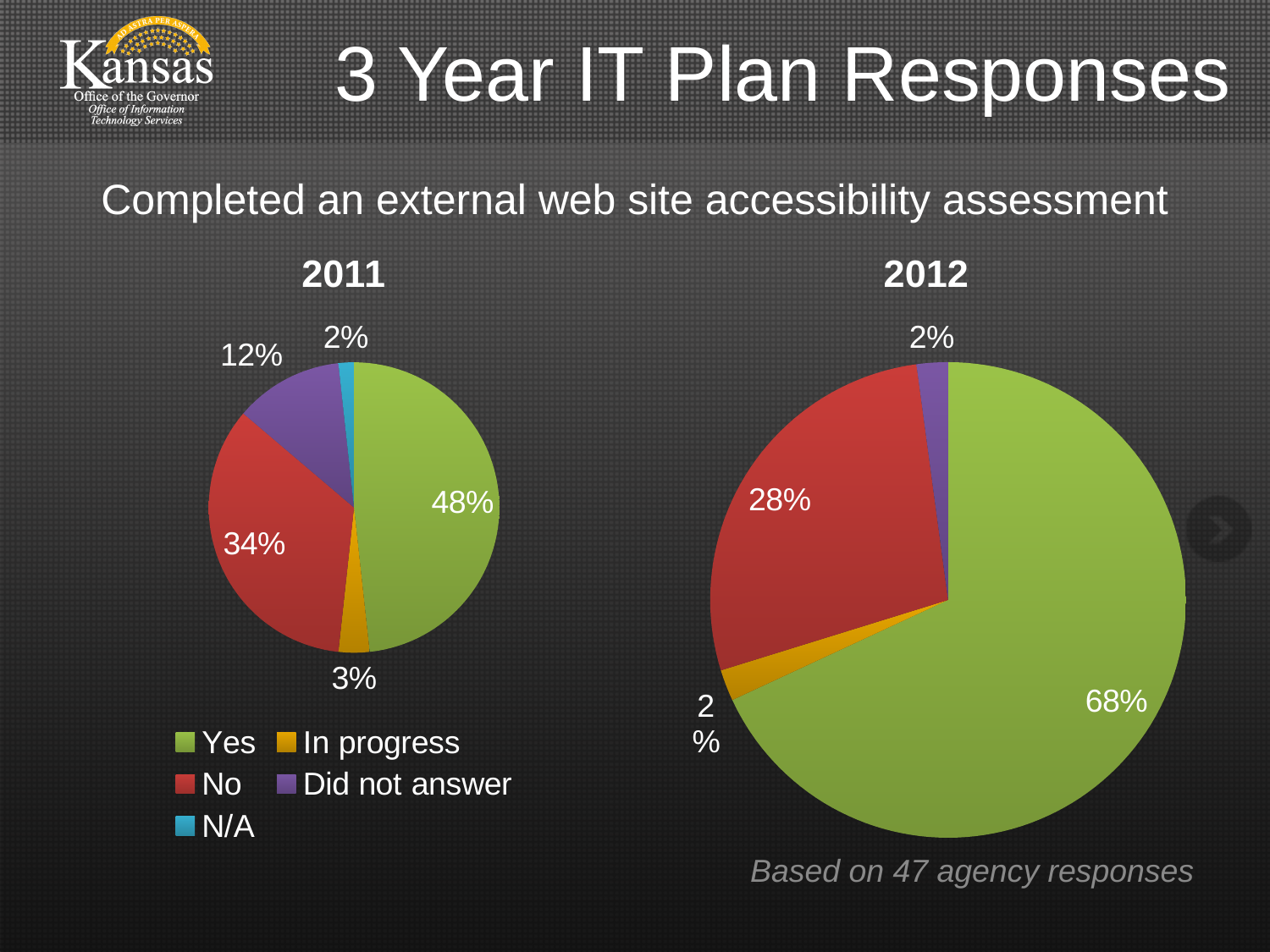
What kind of charts are shown on the slide? Pie charts In the 2011 pie chart, what share of responses is No? 34% In the 2011 pie chart, which category has the smallest slice? N/A In the 2011 pie chart, what share of responses is In progress? 3% What is the difference between the Yes share in 2012 and the Yes share in 2011? 20% How many categories does the legend list? 5 In the 2012 pie chart, what share of responses is Yes? 68% In the 2012 pie chart, what share of responses is No? 28% In the 2011 pie chart, what share of responses is Did not answer? 12% In the 2012 pie chart, which category has the largest slice? Yes Which is larger: the No share in 2011 or the No share in 2012? No share in 2011 In the 2011 pie chart, what share of responses is Yes? 48%